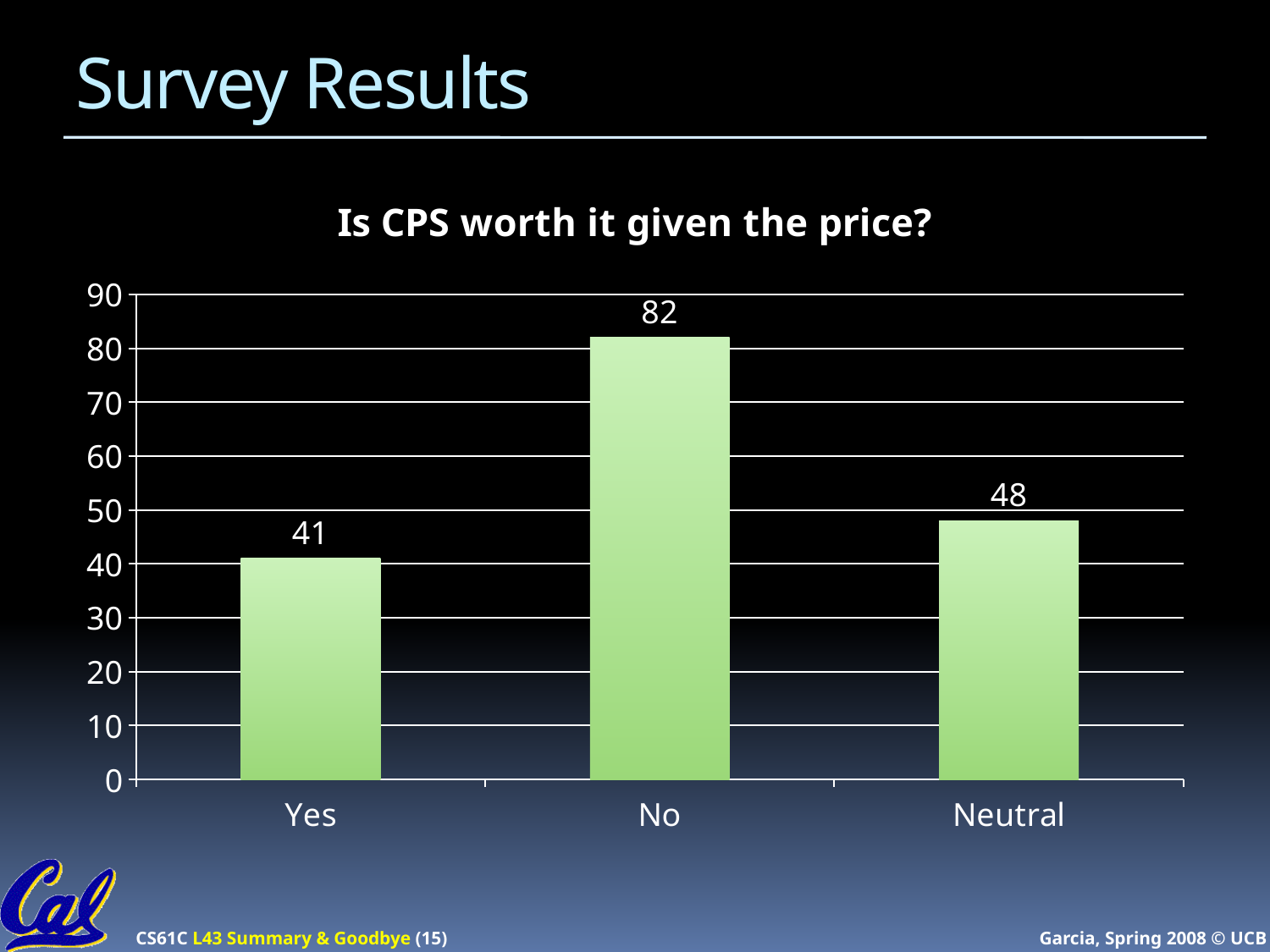
Is the value for "No" greater or less than 80? greater What is the value for "No"? 82 What is the difference between the values for "Neutral" and "Yes"? 7 What is the title of the chart? Is CPS worth it given the price? Which is larger, the value for "Neutral" or the value for "Yes"? Neutral What is the value for "Neutral"? 48 What is the difference between the values for "No" and "Yes"? 41 What kind of chart is shown on the slide? bar chart How many categories are shown on the x axis? 3 Which category has the highest value? No What is the value for "Yes"? 41 Which category has the lowest value? Yes